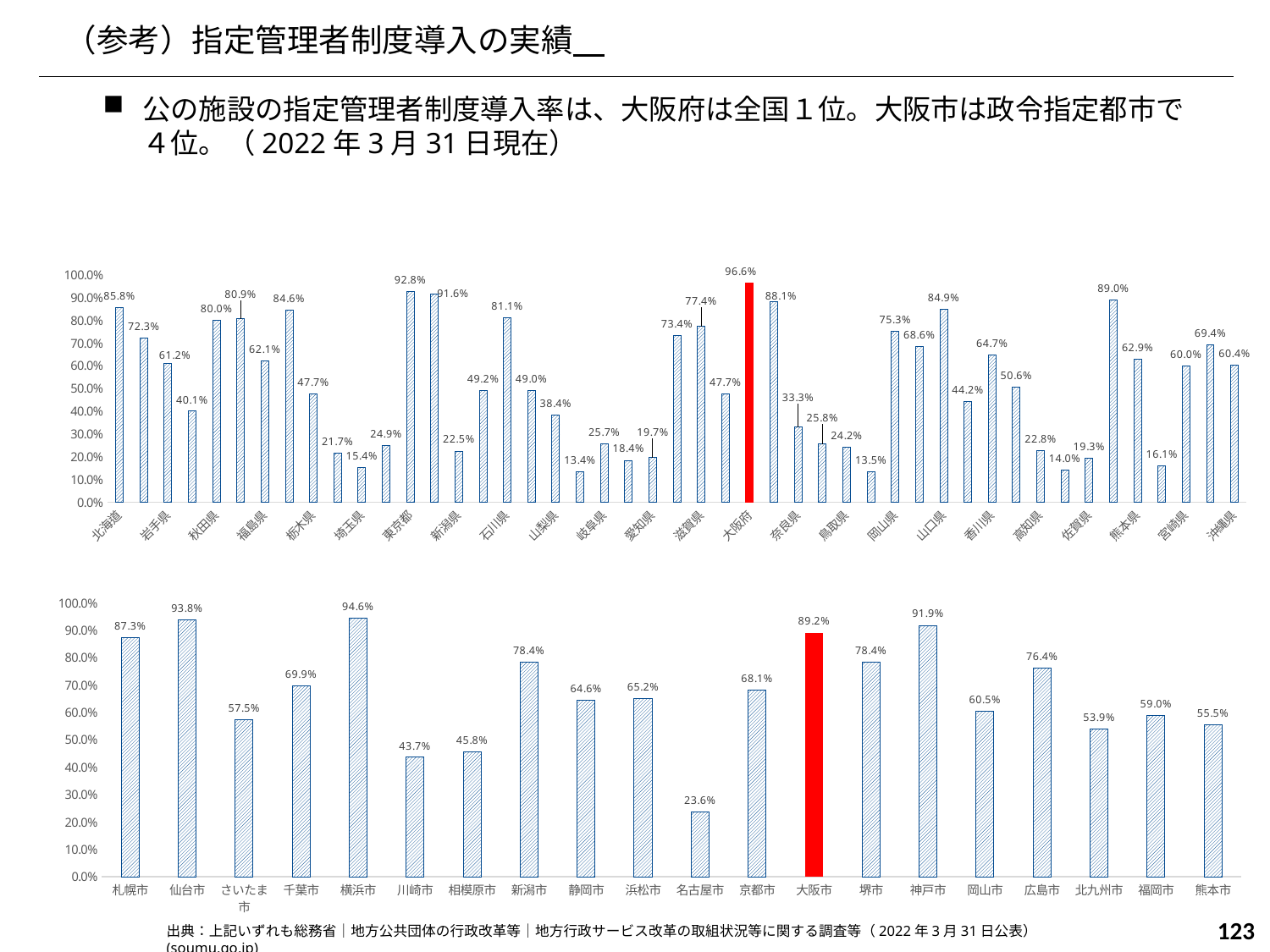
What type of chart is the bottom chart on the slide? bar chart In the bottom chart (designated cities), which city has the highest value? 横浜市 In the bottom chart (designated cities), what is the difference between the values for 横浜市 and 大阪市? 5.4 percentage points In the bottom chart (designated cities), what is the value for 名古屋市? 23.6% In the bottom chart (designated cities), what is the value for 大阪市? 89.2% In the top chart (prefectures), which prefecture has the highest value? 大阪府 In the bottom chart (designated cities), is the value for 川崎市 greater or less than 50.0%? less In the top chart (prefectures), what is the value for 大阪府? 96.6% In the bottom chart (designated cities), which city has the lowest value? 名古屋市 In the top chart (prefectures), what is the value for 北海道? 85.8% In the bottom chart (designated cities), how many cities are shown? 20 In the bottom chart (designated cities), which is larger, the value for 仙台市 or 神戸市? 仙台市